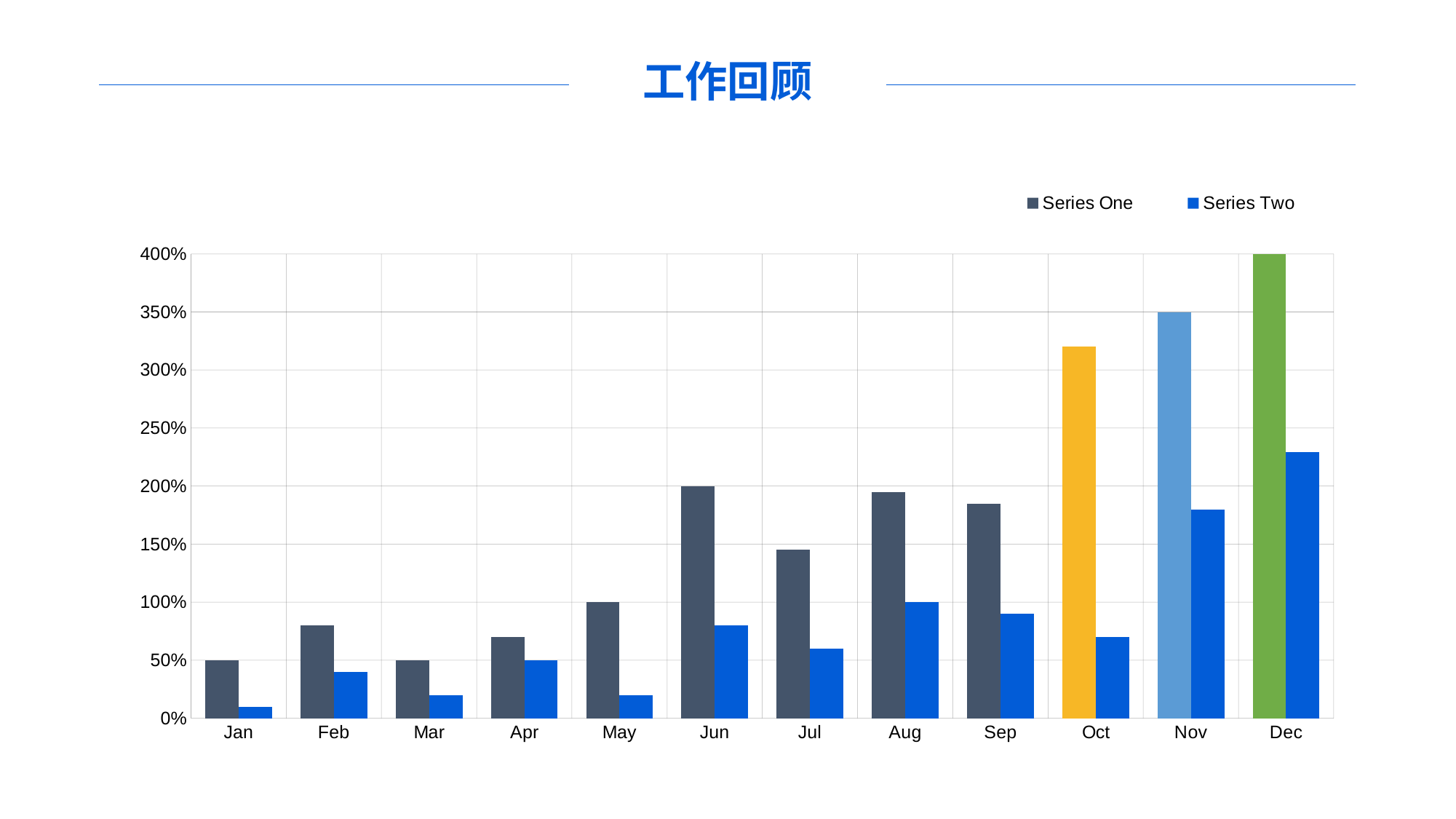
What is the value of Series One for Jun? 200% How many series does the legend list? 2 What type of chart is shown on the slide? Bar chart What is the value of Series One for Dec? 400% How many months are shown on the x axis? 12 What is the value of Series One for May? 100% Which month has the highest Series One value? Dec What is the value of Series One for Nov? 350% Which month has the lowest Series Two value? Jan Which is larger, the Series One value for Jun or for Jul? Jun Is the Series One value for Oct greater or less than 300%? greater What is the title of the slide? 工作回顾